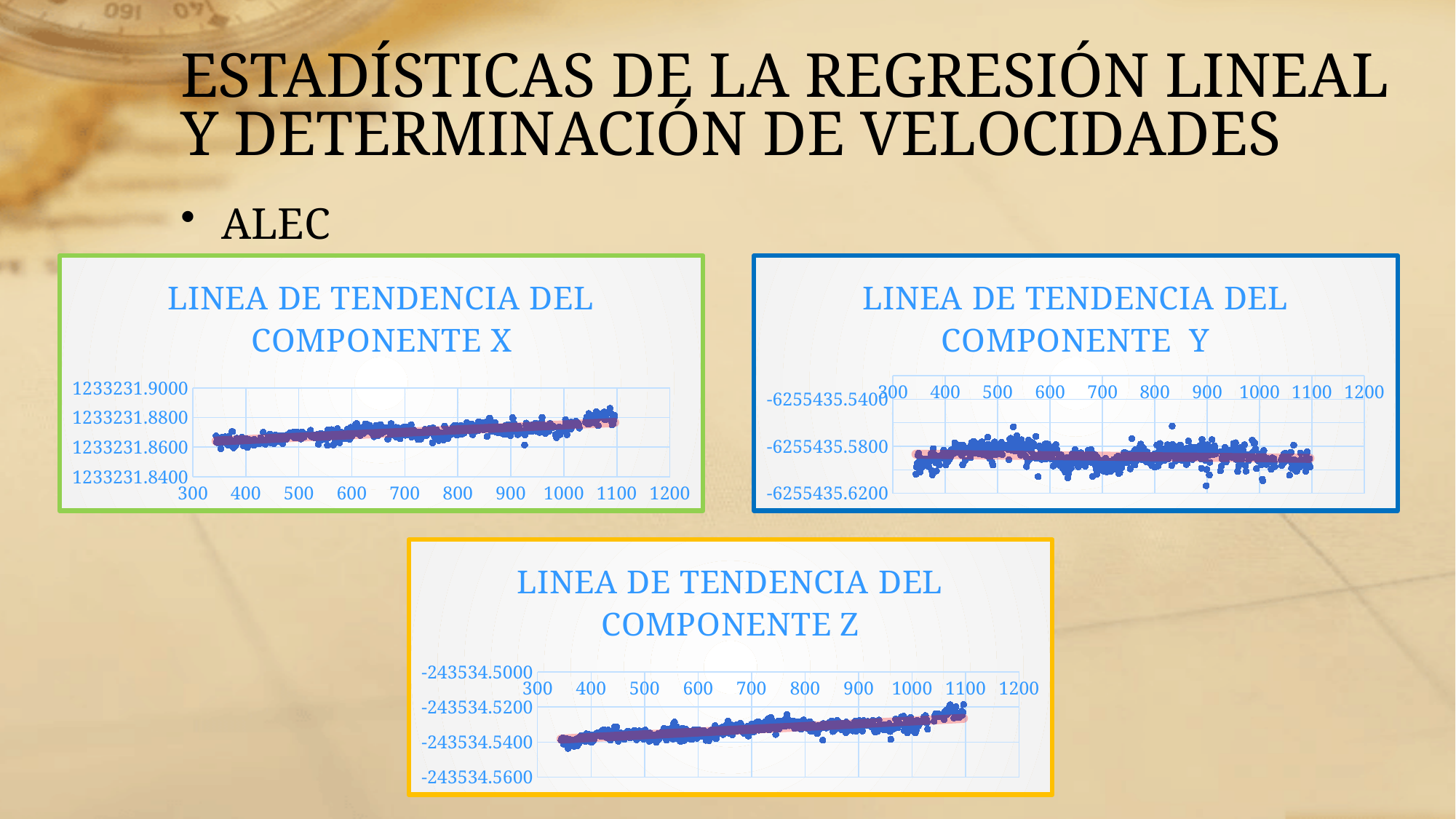
In the chart 'LINEA DE TENDENCIA DEL COMPONENTE Z', is the value at x = 1000 greater or less than -243534.5400? greater In the chart 'LINEA DE TENDENCIA DEL COMPONENTE Y', are the plotted values greater or less than -6255435.5400? less In the chart 'LINEA DE TENDENCIA DEL COMPONENTE Z', is the value at x = 400 greater or less than -243534.5200? less What kind of chart is 'LINEA DE TENDENCIA DEL COMPONENTE X'? scatter chart In the chart 'LINEA DE TENDENCIA DEL COMPONENTE X', do the values rise or fall as the x axis increases from 300 to 1100? rise What is the title of the chart at the bottom of the slide? LINEA DE TENDENCIA DEL COMPONENTE Z In the chart 'LINEA DE TENDENCIA DEL COMPONENTE Z', do the values rise or fall as the x axis increases from 300 to 1100? rise What is the highest tick label on the vertical axis of the chart 'LINEA DE TENDENCIA DEL COMPONENTE X'? 1233231.9000 How many charts are shown on the slide? 3